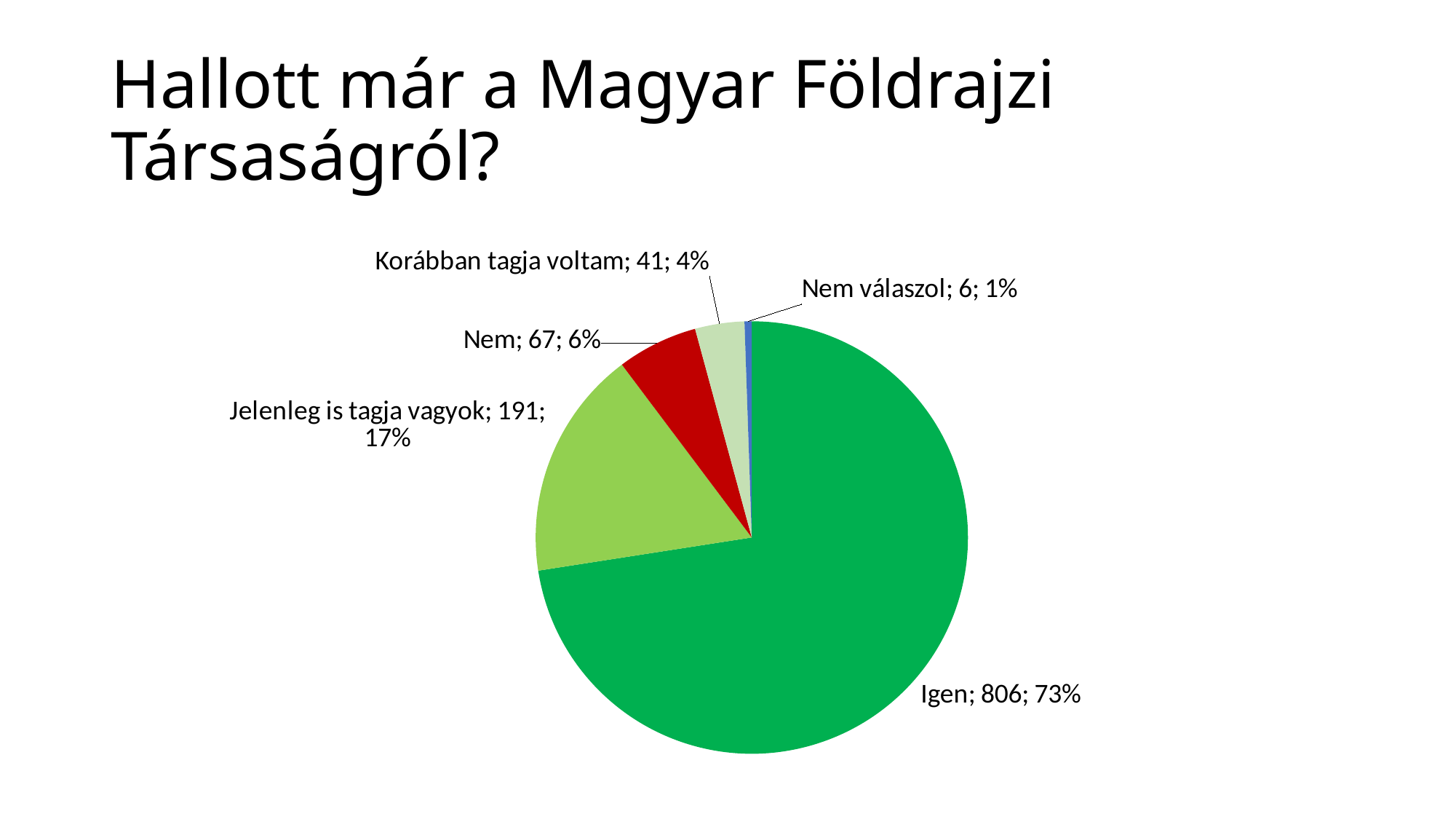
How many slices does the pie chart have? 5 Which category has the largest slice? Igen What is the value for "Korábban tagja voltam"? 41 What is the value for "Nem"? 67 What share of the pie does "Igen" represent? 73% What is the difference between the values for "Jelenleg is tagja vagyok" and "Nem"? 124 What kind of chart is shown on the slide? pie chart What share of the pie does "Nem válaszol" represent? 1% What is the value for "Jelenleg is tagja vagyok"? 191 Which category has the smallest slice? Nem válaszol Which is larger, the value for "Nem" or the value for "Korábban tagja voltam"? Nem What is the value for "Igen"? 806